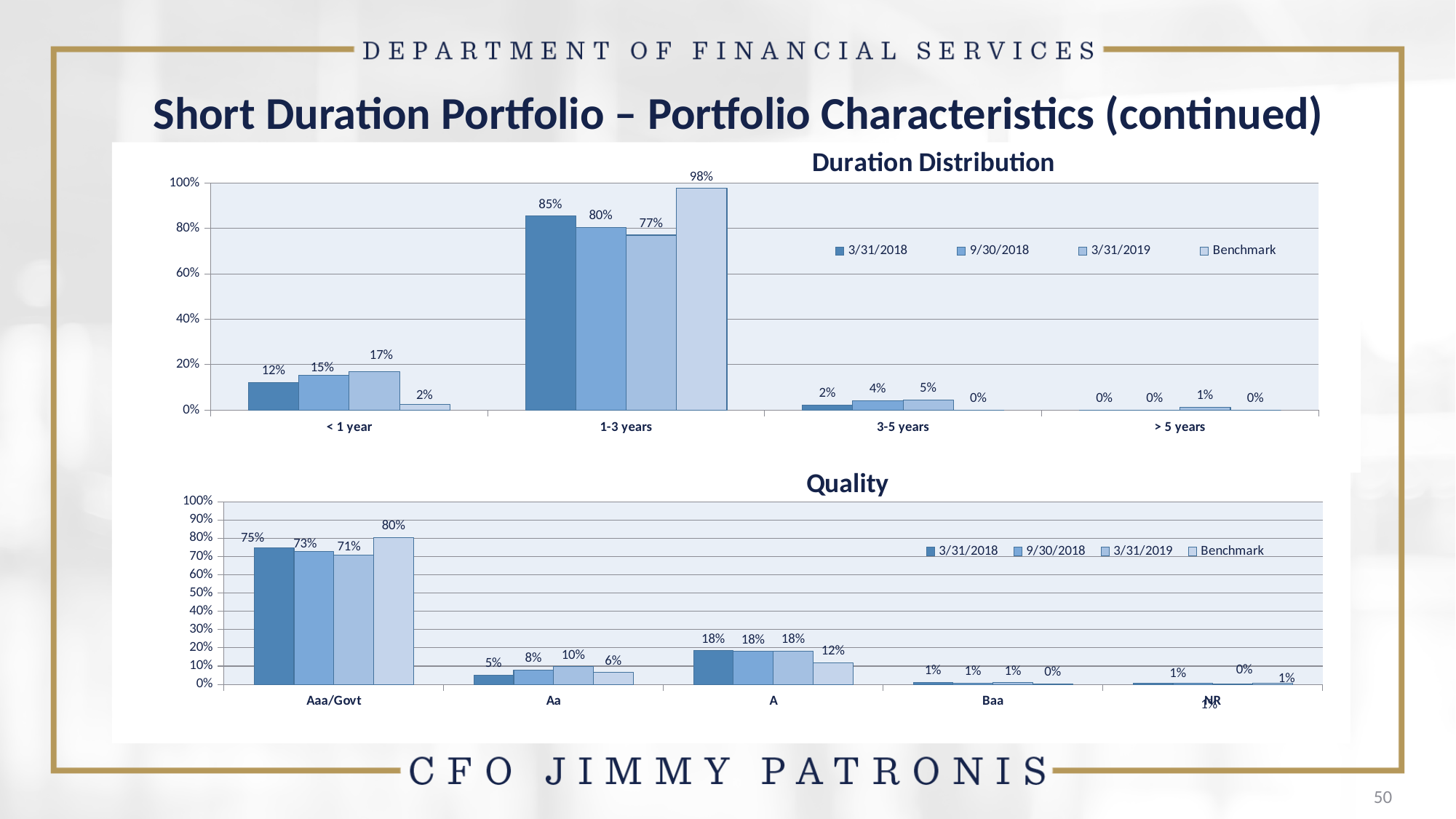
In the Duration Distribution chart, what is the difference between the 3/31/2018 and 3/31/2019 values for 1-3 years? 8% In the Quality chart, what is the 9/30/2018 value for Aa? 8% In the Duration Distribution chart, how many duration categories are shown on the x axis? 4 In the Quality chart, which is larger for the A rating: the 3/31/2019 value or the Benchmark value? 3/31/2019 In the Duration Distribution chart, what is the Benchmark value for 1-3 years? 98% In the Duration Distribution chart, which duration bucket has the highest 3/31/2018 value? 1-3 years In the Duration Distribution chart, what is the 3/31/2019 value for < 1 year? 17% In the Quality chart, how many rating categories are shown on the x axis? 5 In the Duration Distribution chart, how many series does the legend list? 4 In the Quality chart, what is the Benchmark value for Aaa/Govt? 80% In the Quality chart, what is the difference between the 3/31/2018 and 3/31/2019 values for Aaa/Govt? 4% What kind of chart is the Quality chart? Bar chart